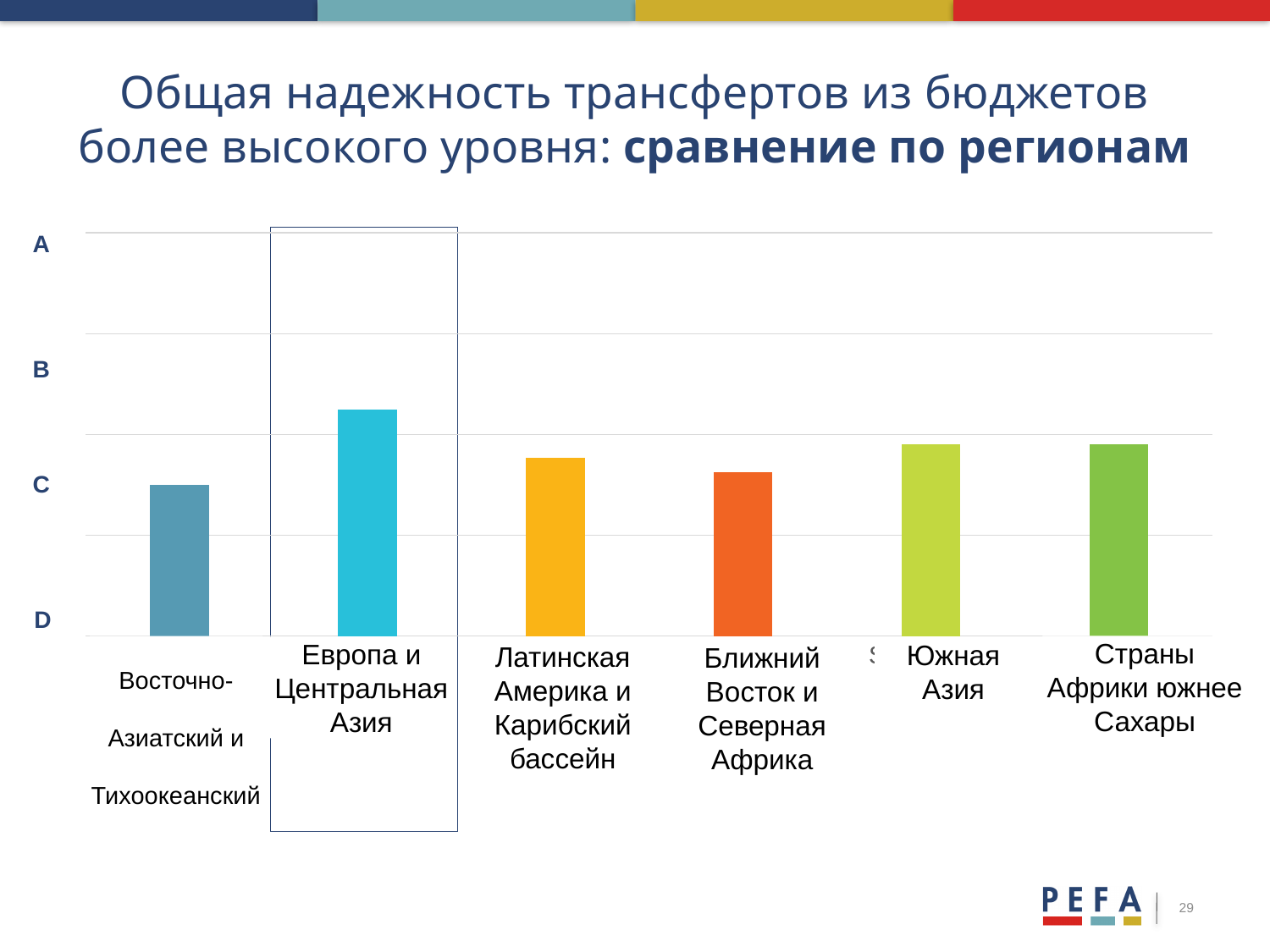
Which bar is taller: Страны Африки южнее Сахары or Ближний Восток и Северная Африка? Страны Африки южнее Сахары Which region has the lowest bar in the chart? Восточно-Азиатский и Тихоокеанский Which bar is taller: Европа и Центральная Азия or Страны Африки южнее Сахары? Европа и Центральная Азия What kind of chart is shown on the slide? Bar chart How many regions (bars) are shown in the chart? 6 What labels are shown on the vertical axis of the chart? A, B, C, D Which region has the highest bar in the chart? Европа и Центральная Азия Which region's bar is outlined with a highlight box on the chart? Европа и Центральная Азия Which bar is taller: Европа и Центральная Азия or Восточно-Азиатский и Тихоокеанский? Европа и Центральная Азия